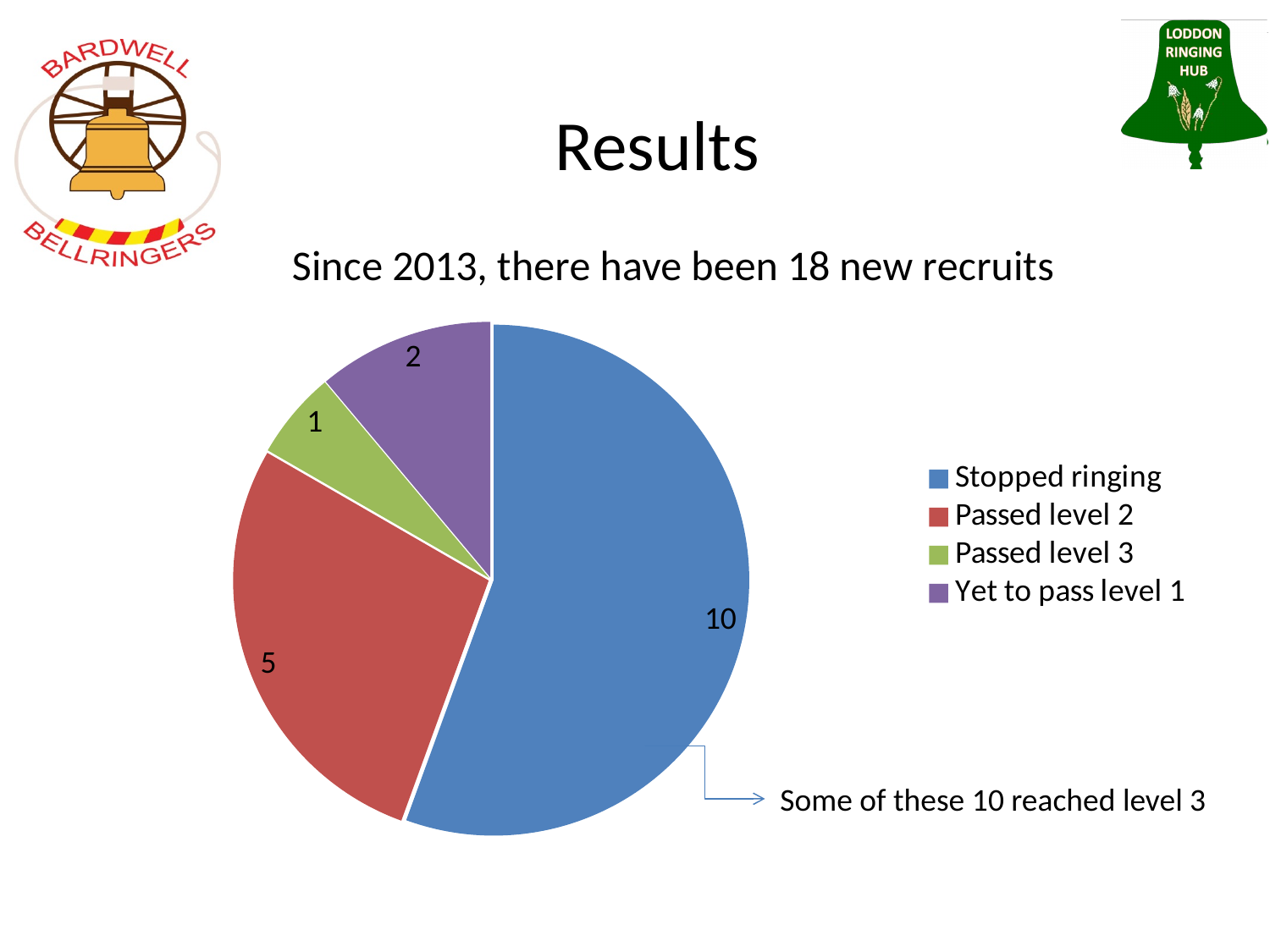
What is the difference between the number who stopped ringing and the number who passed level 2? 5 Which is larger: the number yet to pass level 1 or the number who passed level 3? Yet to pass level 1 What is the total of all the slices in the pie chart? 18 How many recruits are yet to pass level 1 according to the pie chart? 2 What kind of chart is shown on the slide? pie chart What colour is the 'Passed level 2' slice in the pie chart? red How many recruits passed level 3 according to the pie chart? 1 How many categories does the legend of the pie chart list? 4 Which category has the largest slice of the pie chart? Stopped ringing How many recruits passed level 2 according to the pie chart? 5 How many recruits stopped ringing according to the pie chart? 10 Which category has the smallest slice of the pie chart? Passed level 3